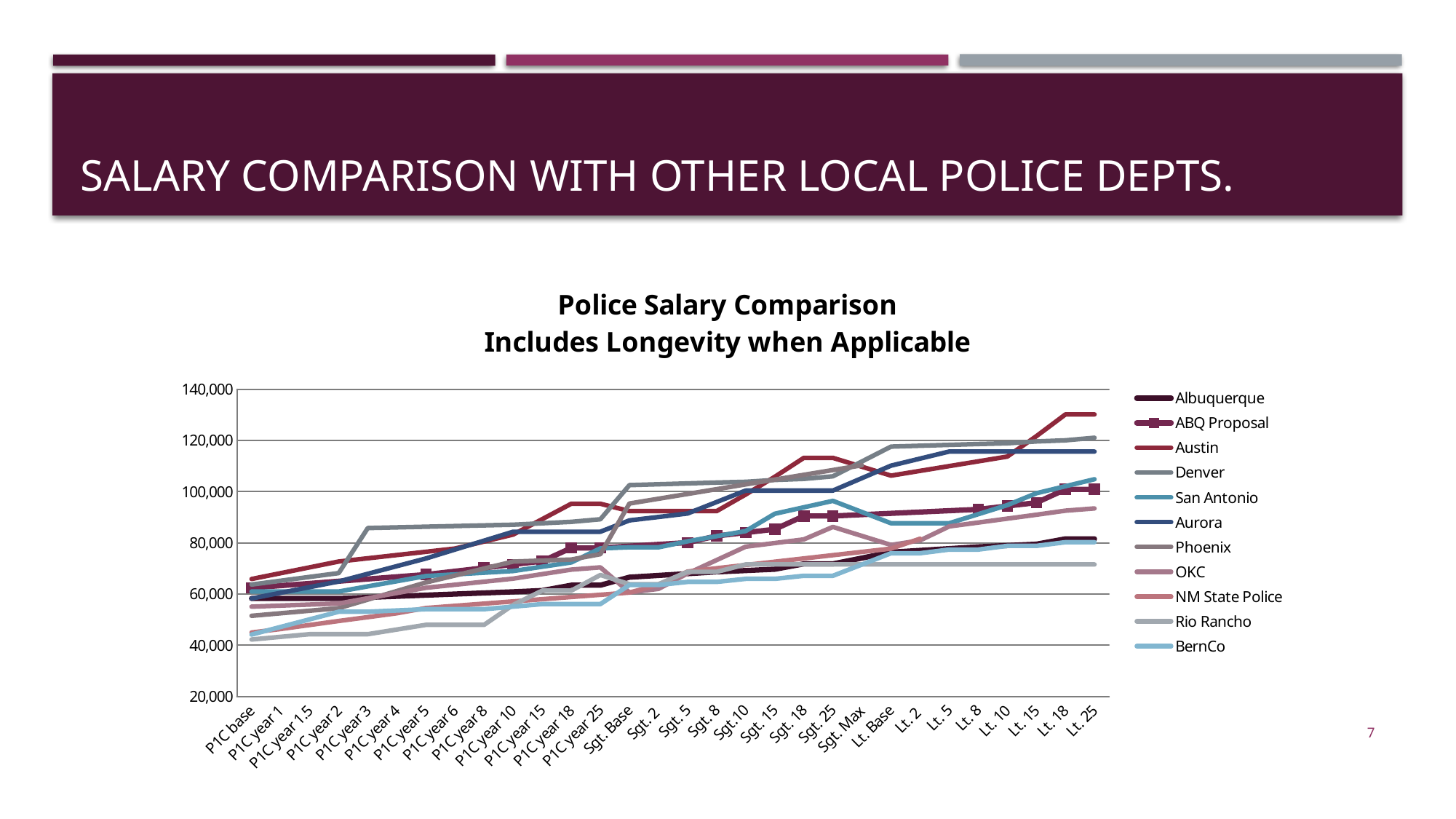
Is the value for Austin at Lt. 25 greater or less than 120,000? greater How many series does the legend list? 11 Is the value for Rio Rancho at Lt. 25 greater or less than 80,000? less Which series is highest at Lt. 25? Austin What kind of chart is shown on the slide? Line chart What is the title of the chart? Police Salary Comparison Includes Longevity when Applicable How many categories are shown along the x axis? 30 Which series in the legend is drawn with square markers on its line? ABQ Proposal Is the value for BernCo at P1C base greater or less than 60,000? less Does the Austin line generally rise or fall from P1C base to Lt. 25? Rise Which is larger at Sgt. Base, Denver or Albuquerque? Denver Which series is lowest at Lt. 25? Rio Rancho